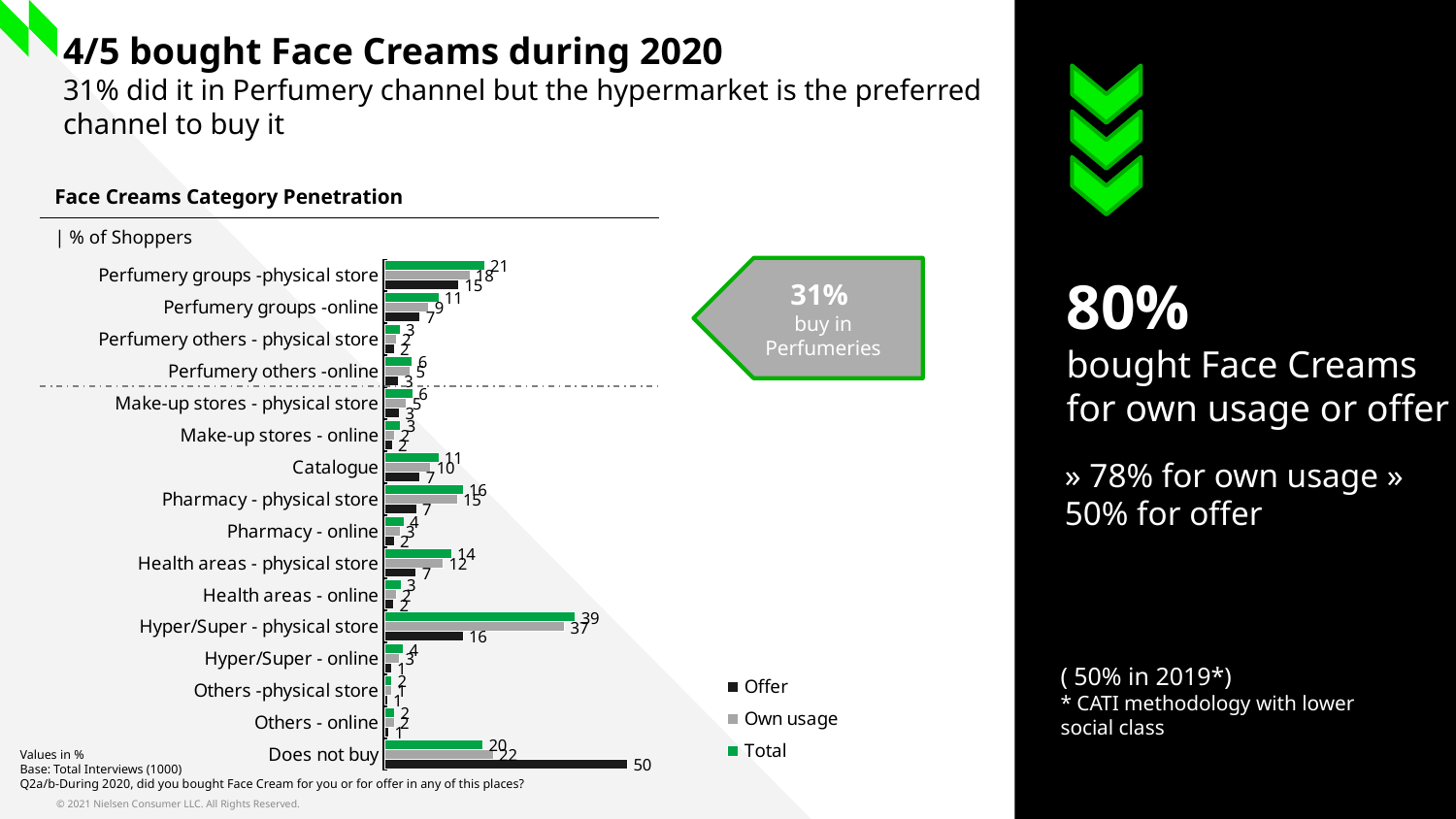
What is the Total value for Pharmacy - physical store? 16 Which has a larger Total value: Perfumery groups - physical store or Pharmacy - physical store? Perfumery groups - physical store What is the difference between the Total and Offer values for Hyper/Super - physical store? 23 Which category has the highest Total value? Hyper/Super - physical store What type of chart is shown on the slide? Bar chart How many series does the chart legend list? 3 How many categories are shown on the chart's vertical axis? 16 What is the Total value for Perfumery groups - physical store? 21 What are the three series listed in the chart legend? Offer, Own usage, Total What is the Total value for Hyper/Super - physical store? 39 What is the Offer value for Hyper/Super - physical store? 16 What is the Offer value for Does not buy? 50